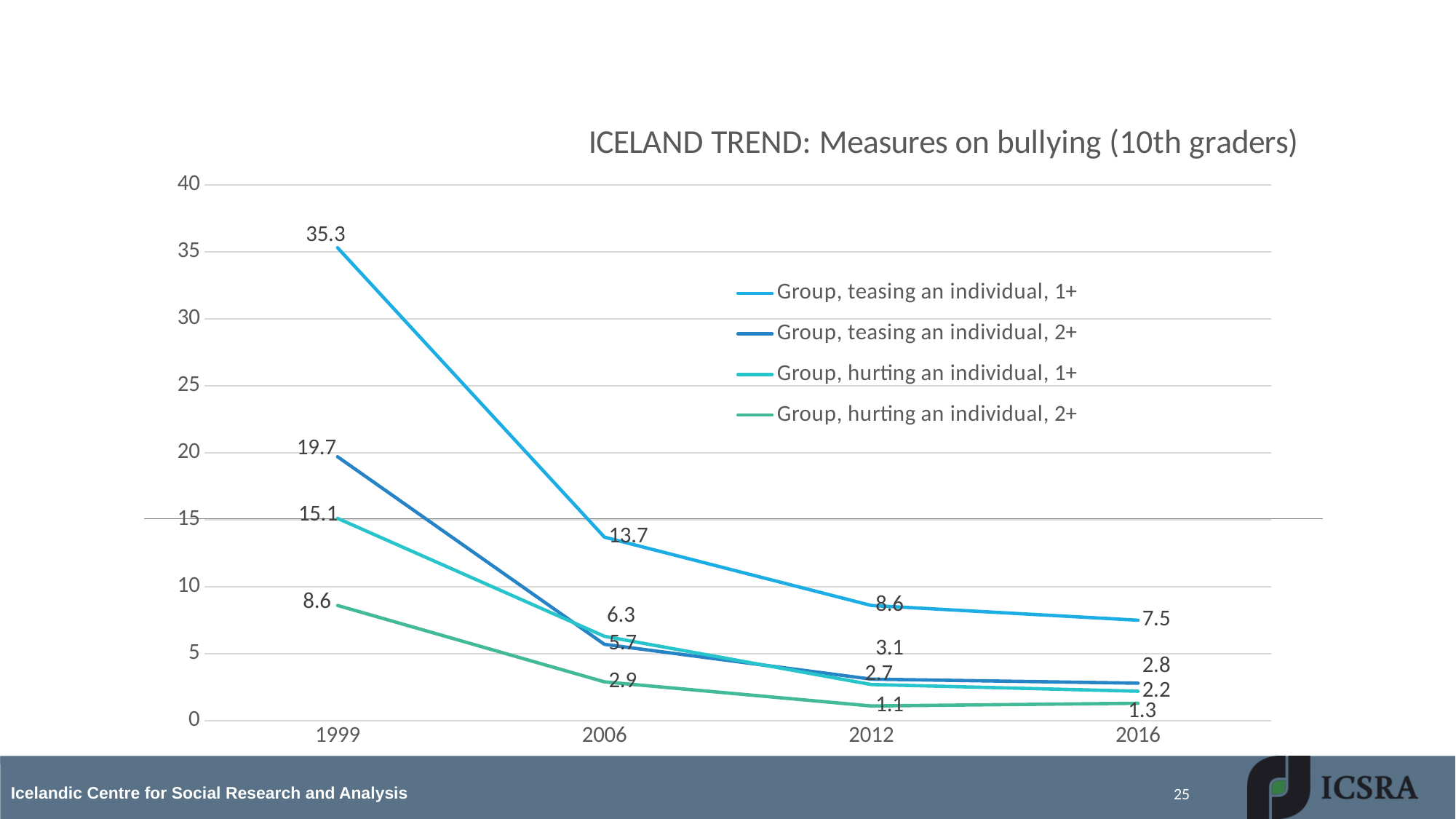
Which series has the lowest value in 2012? Group, hurting an individual, 2+ Does the value for 'Group, teasing an individual, 1+' rise or fall from 1999 to 2016? fall In which year is the value for 'Group, teasing an individual, 1+' highest? 1999 What is the value for 'Group, teasing an individual, 1+' in 2016? 7.5 What is the value for 'Group, teasing an individual, 1+' in 1999? 35.3 How many years are shown on the x axis? 4 Is the 1999 value for 'Group, teasing an individual, 2+' greater or less than 15? greater What kind of chart is shown on the slide? line chart In 2006, which is larger: 'Group, teasing an individual, 1+' or 'Group, hurting an individual, 1+'? Group, teasing an individual, 1+ How many series does the legend list? 4 What is the difference between the 1999 and 2016 values for 'Group, teasing an individual, 1+'? 27.8 What is the value for 'Group, hurting an individual, 2+' in 2012? 1.1